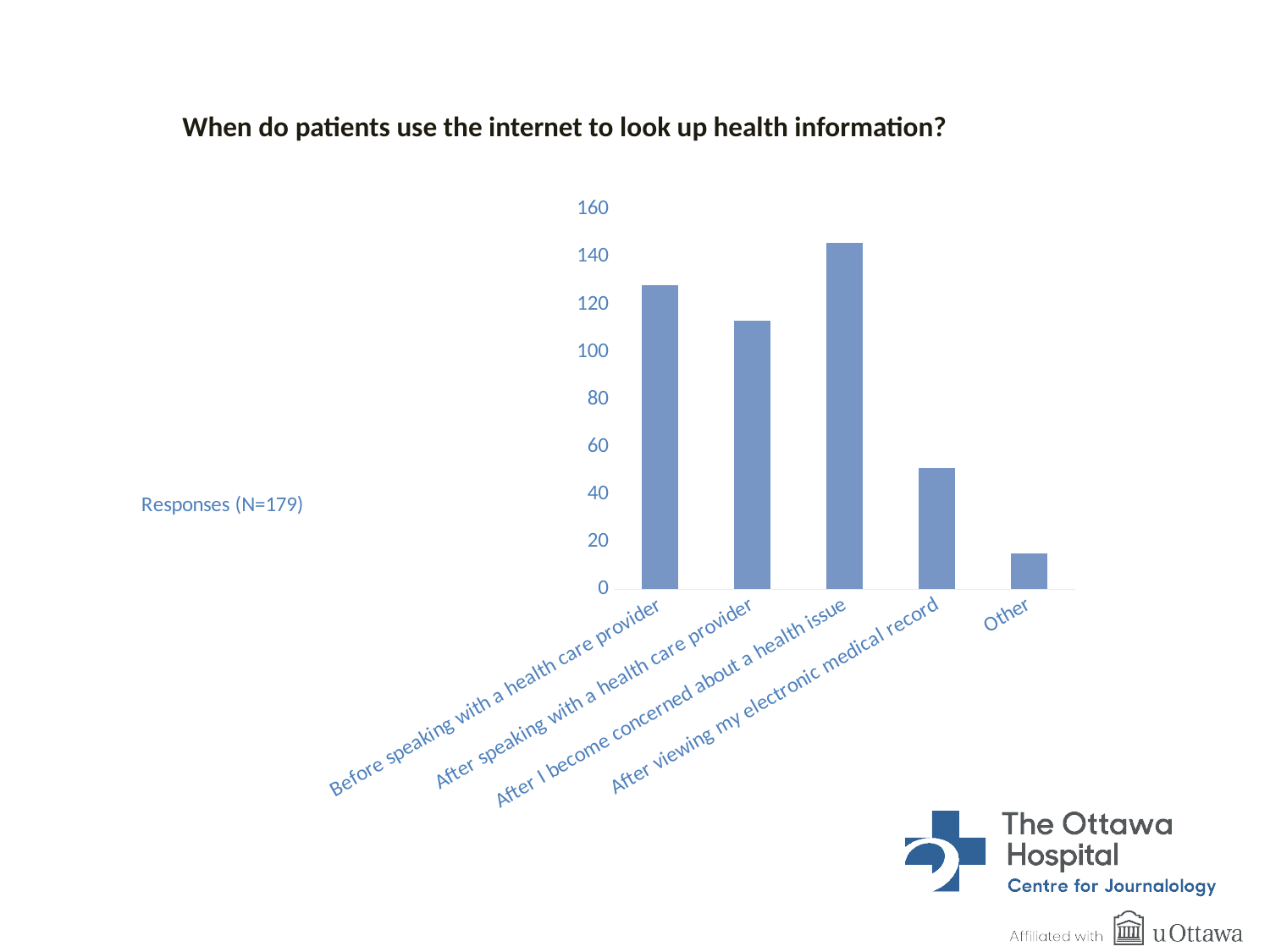
How many categories are shown on the x axis of the chart? 5 Which category has the lowest number of responses? Other Is the value for 'Before speaking with a health care provider' greater or less than 120? greater What is the title of the chart? When do patients use the internet to look up health information? Which has more responses: 'Before speaking with a health care provider' or 'After speaking with a health care provider'? Before speaking with a health care provider What is the label of the vertical axis? Responses (N=179) Is the value for 'After speaking with a health care provider' greater or less than 120? less What kind of chart is shown on the slide? bar chart Is the value for 'After viewing my electronic medical record' greater or less than 60? less Which category has the highest number of responses? After I become concerned about a health issue